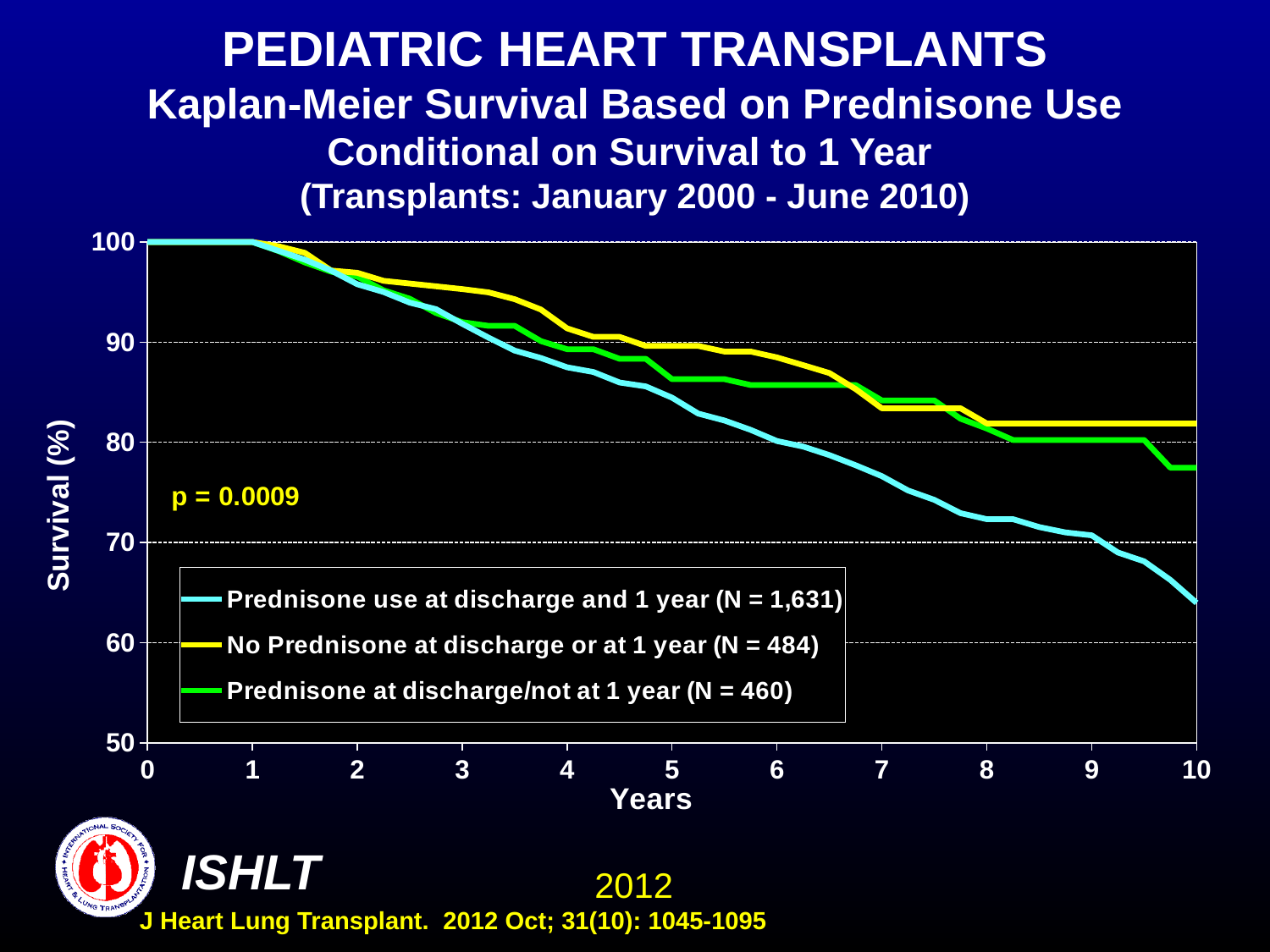
Do the survival curves rise or fall as years increase? fall Which group has the highest survival at 10 years? No Prednisone at discharge or at 1 year At 10 years, which group has higher survival: 'Prednisone at discharge/not at 1 year' or 'Prednisone use at discharge and 1 year'? Prednisone at discharge/not at 1 year What is the N for the 'Prednisone use at discharge and 1 year' group? 1,631 Which group has the lowest survival at 10 years? Prednisone use at discharge and 1 year Is the survival for the 'Prednisone use at discharge and 1 year' group at 5 years greater or less than 80? greater How many series does the legend list? 3 Is the survival for the 'No Prednisone at discharge or at 1 year' group at 10 years greater or less than 80? greater Is the survival for the 'Prednisone at discharge/not at 1 year' group at 10 years greater or less than 80? less What kind of chart is shown on the slide? line chart What p-value is shown on the chart? p = 0.0009